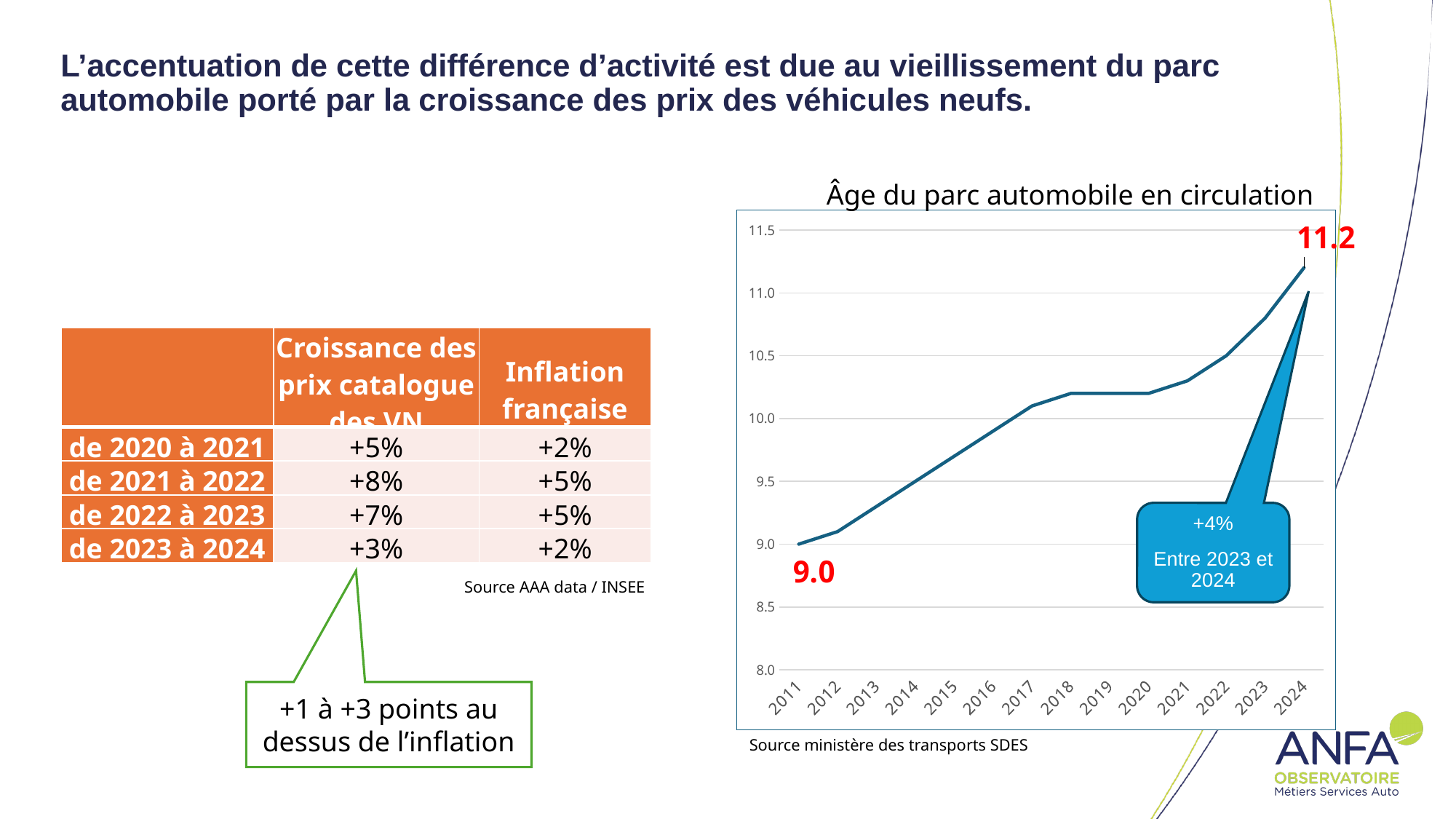
Which year has the lowest value in the chart? 2011 What is the difference between the values for 2024 and 2011? 2.2 What kind of chart is shown on the slide? line chart Do the values in the chart rise or fall from 2011 to 2024? rise Is the value for 2012 greater or less than 9.5? less How many years are plotted on the x axis of the chart? 14 What percentage change does the callout on the chart give between 2023 and 2024? +4% Is the value for 2018 greater or less than 10.0? greater What is the value for 2024 in the chart? 11.2 What is the title of the chart? Âge du parc automobile en circulation What is the value for 2011 in the chart? 9.0 Which year has the highest value in the chart? 2024